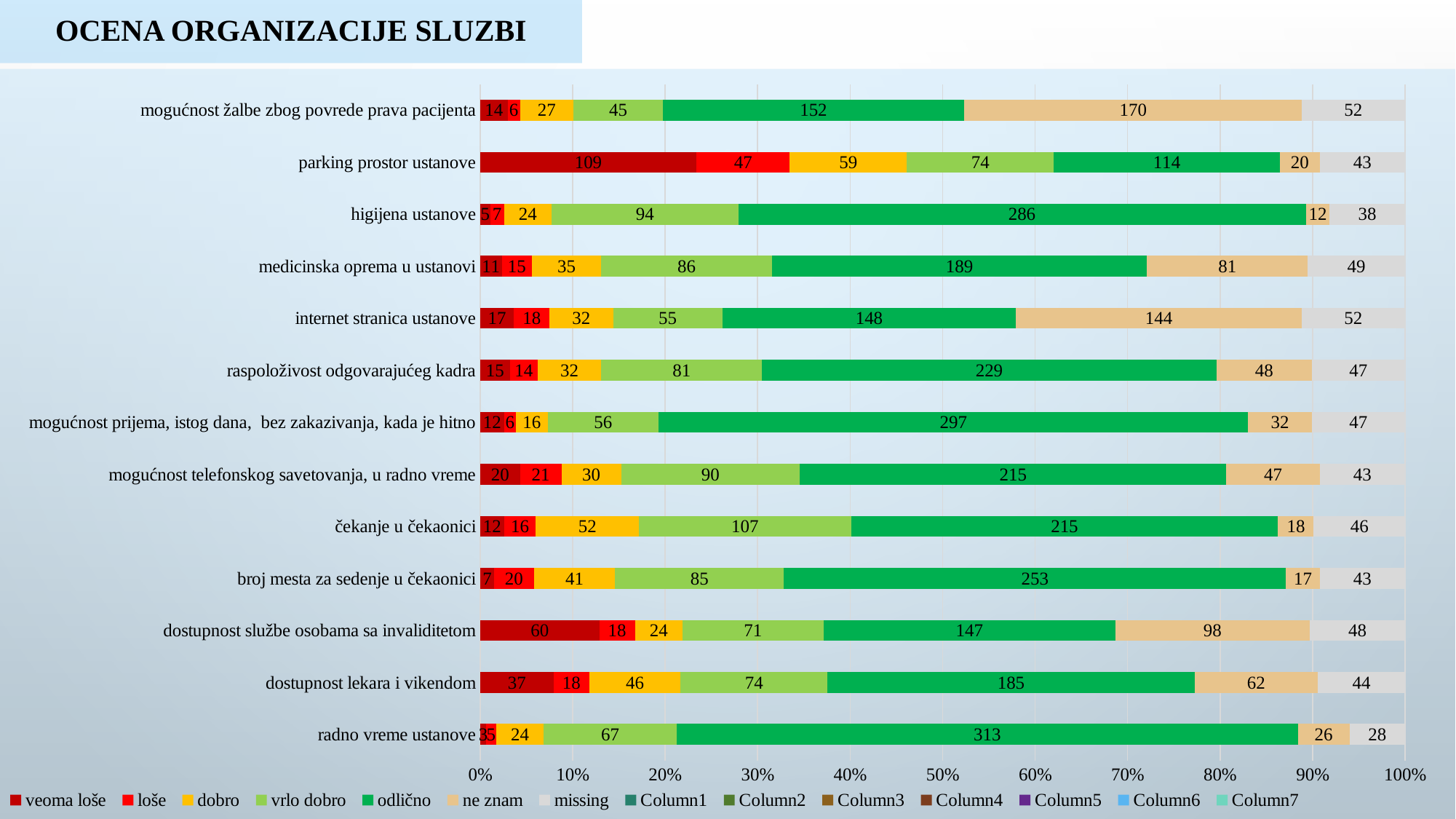
What kind of chart is shown on the slide? stacked bar chart How many series does the legend list? 14 Which category has the highest "veoma loše" value? parking prostor ustanove Which has the larger "dobro" value: "parking prostor ustanove" or "čekanje u čekaonici"? parking prostor ustanove What is the "ne znam" value for "mogućnost žalbe zbog povrede prava pacijenta"? 170 Which category has the highest "odlično" value? radno vreme ustanove What is the "veoma loše" value for "parking prostor ustanove"? 109 What is the "odlično" value for "radno vreme ustanove"? 313 How many categories are shown on the chart? 13 What is the "vrlo dobro" value for "čekanje u čekaonici"? 107 What is the total of all labelled segments in the "parking prostor ustanove" bar? 466 What is the difference between the "odlično" values for "mogućnost prijema, istog dana, bez zakazivanja, kada je hitno" and "raspoloživost odgovarajućeg kadra"? 68